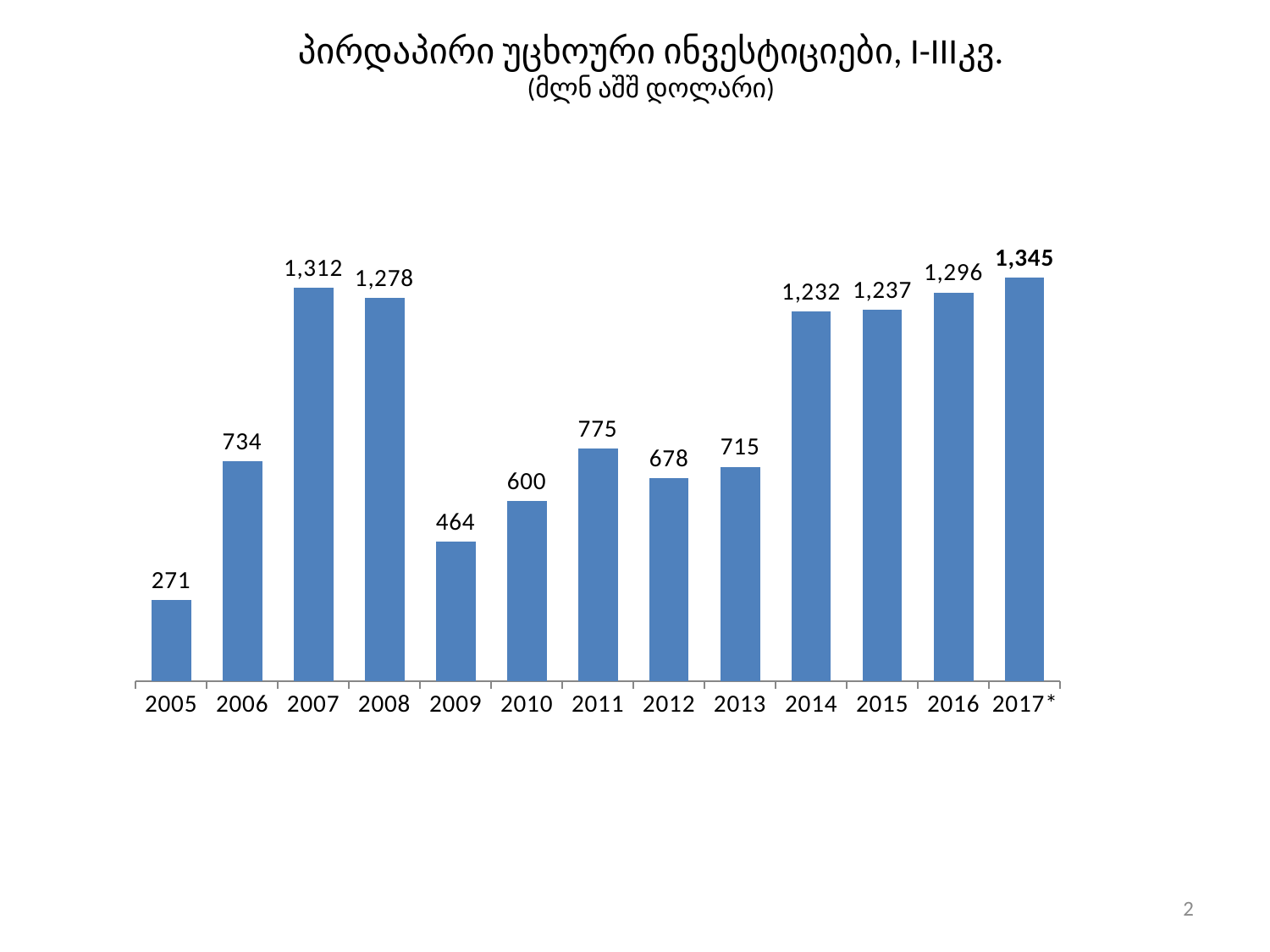
What is the difference between the values for 2017* and 2016? 49 What is the value for 2009? 464 What kind of chart is this? bar chart Which year has the highest value? 2017* Do the values rise or fall from 2014 to 2017*? rise What is the difference between the values for 2007 and 2008? 34 What unit is given in the chart subtitle? მლნ აშშ დოლარი How many years are shown on the x axis? 13 Which is larger, the value for 2011 or the value for 2013? 2011 What is the value for 2017*? 1,345 What is the value for 2005? 271 Which year has the lowest value? 2005